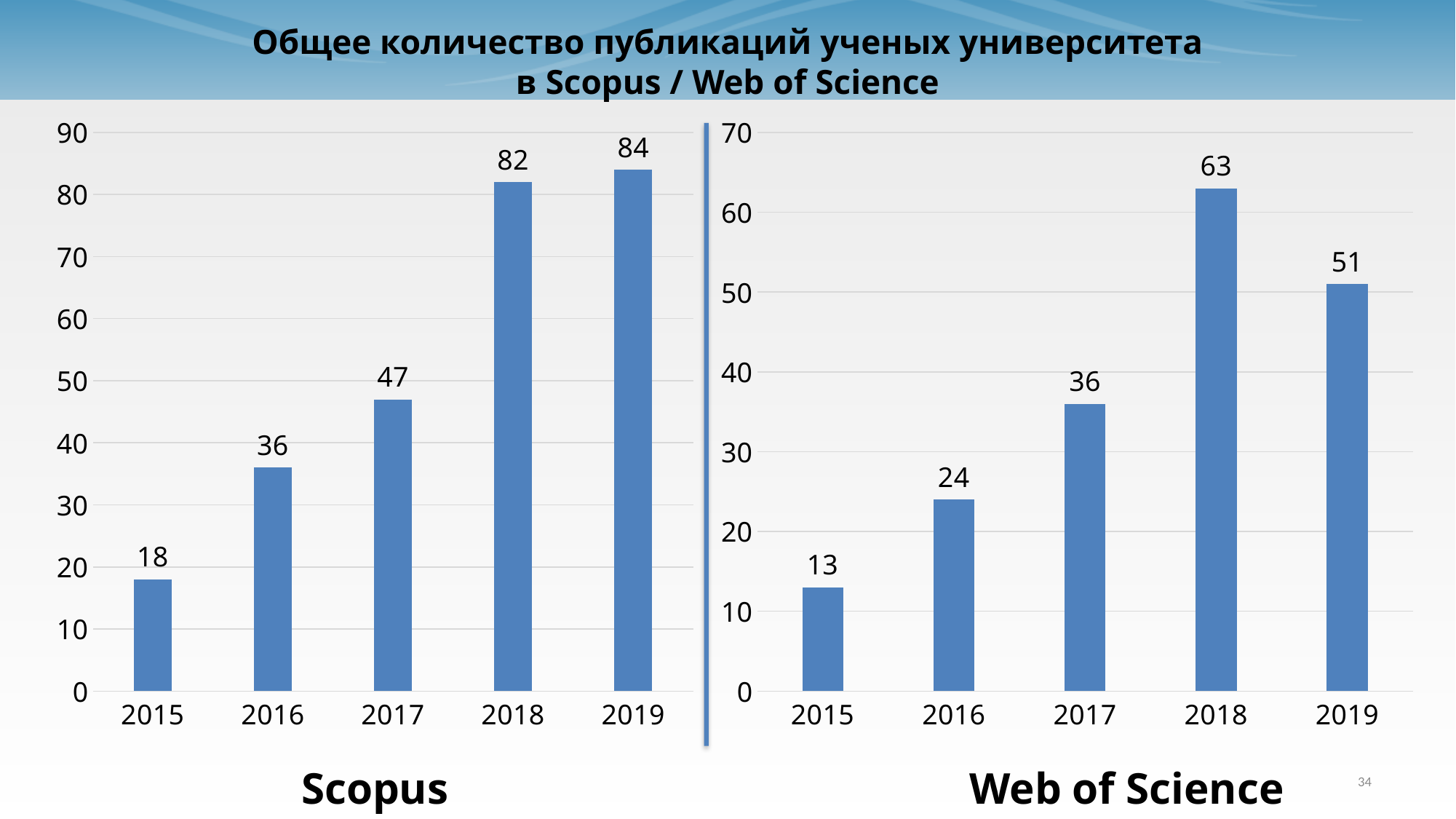
In the Scopus chart, which is larger, the value for 2016 or the value for 2017? 2017 How many years are shown on the x axis of the Scopus chart? 5 In the Web of Science chart, which year has the lowest value? 2015 In the Scopus chart, which year has the highest value? 2019 In the Web of Science chart, what is the difference between the values for 2018 and 2019? 12 In the Scopus chart, what is the value for 2017? 47 What kind of chart is the Web of Science chart? bar chart In the Web of Science chart, what is the value for 2016? 24 In the Web of Science chart, which year has the highest value? 2018 In the Scopus chart, do the values rise or fall from 2015 to 2019? rise In the Web of Science chart, is the value for 2017 greater or less than 30? greater In the Scopus chart, what is the difference between the values for 2018 and 2017? 35